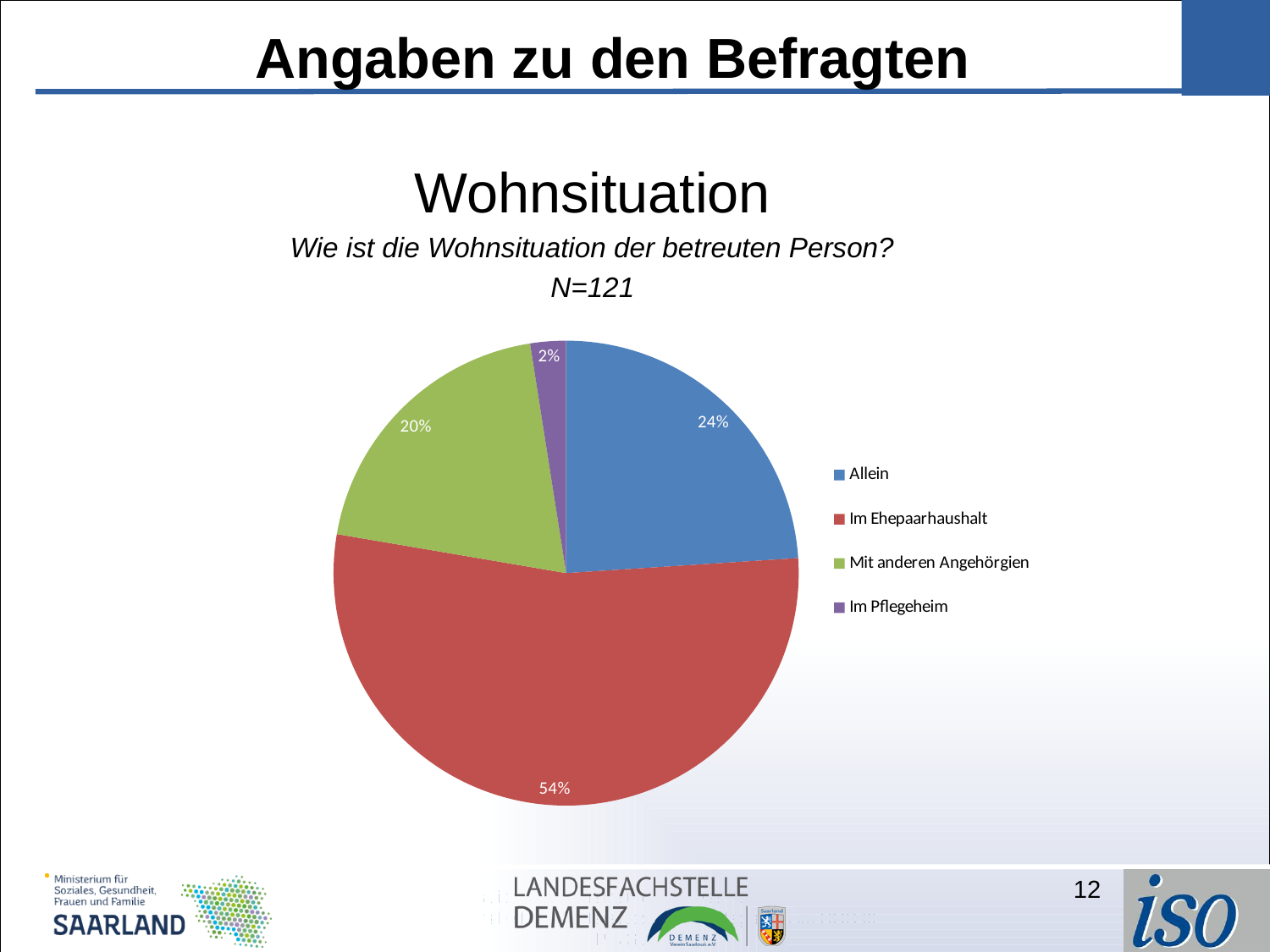
How many categories does the legend list? 4 Which category has the smallest slice of the pie? Im Pflegeheim What is the sample size (N) stated above the chart? N=121 What is the title of the chart? Wohnsituation What kind of chart is shown on the slide? pie chart Which is larger, the slice for "Allein" or the slice for "Mit anderen Angehörigen"? Allein What is the difference in percentage points between "Im Ehepaarhaushalt" and "Allein"? 30 What share of the pie is labelled "Mit anderen Angehörigen"? 20% What share of the pie is labelled "Im Pflegeheim"? 2% Which category has the largest slice of the pie? Im Ehepaarhaushalt What share of the pie is labelled "Allein"? 24%